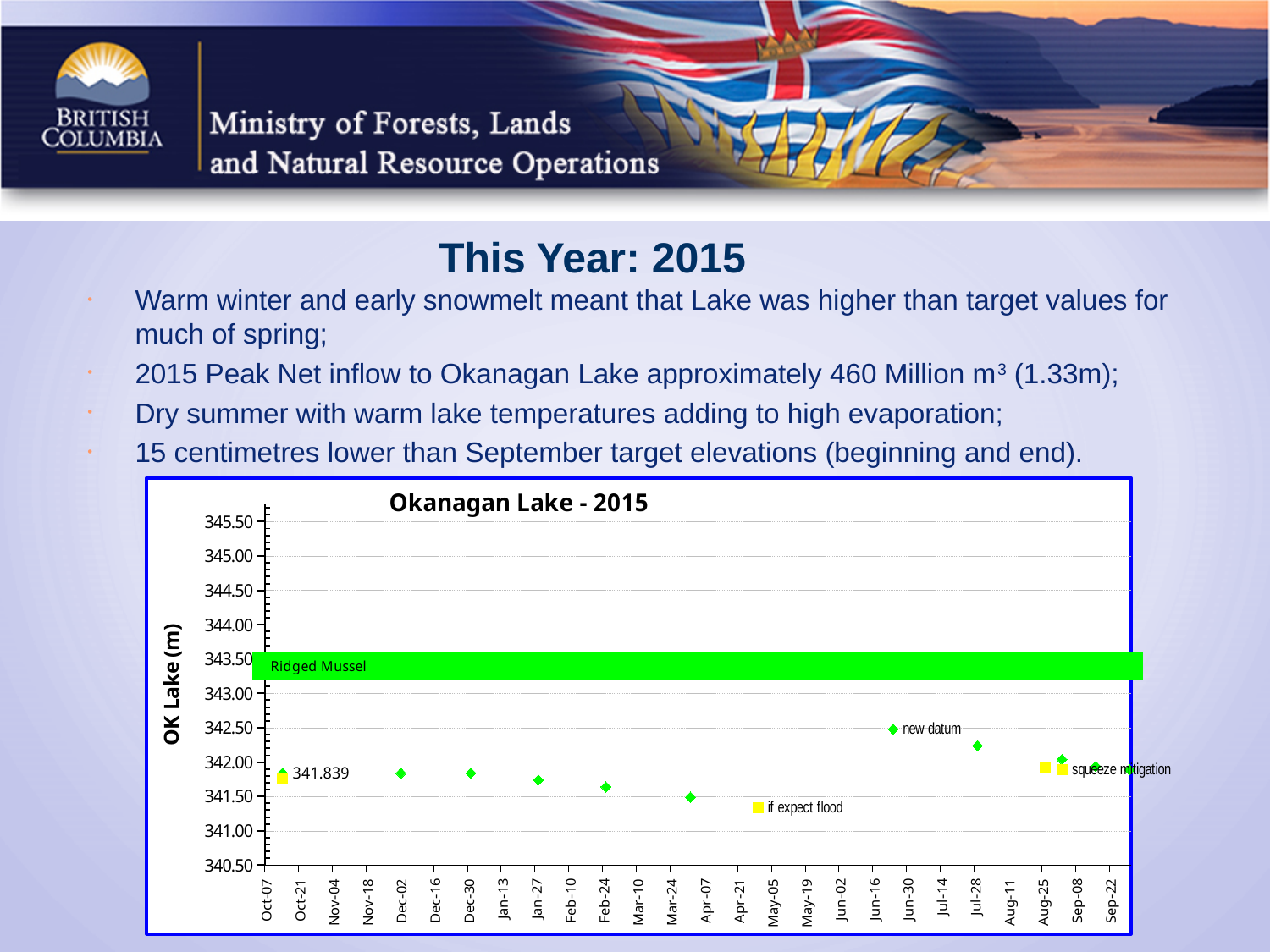
What is the lowest value shown on the vertical axis of the chart? 340.50 Is the value for Jul-28 greater or less than 343.00? less Is the value for Apr-07 greater or less than 342.00? less What is the label on the vertical axis of the chart? OK Lake (m) Which of the green diamond points is the highest on the chart? Jun-30 Is the value for Oct-07 greater or less than 342.00? less Which of the green diamond points is the lowest on the chart? Apr-07 What value is printed as a data label next to the first point (Oct-07) on the chart? 341.839 Do the green diamond values rise or fall from Oct-07 to Apr-07? fall Which is larger, the value for Jun-30 or the value for Jul-28? Jun-30 What is the title of the chart? Okanagan Lake - 2015